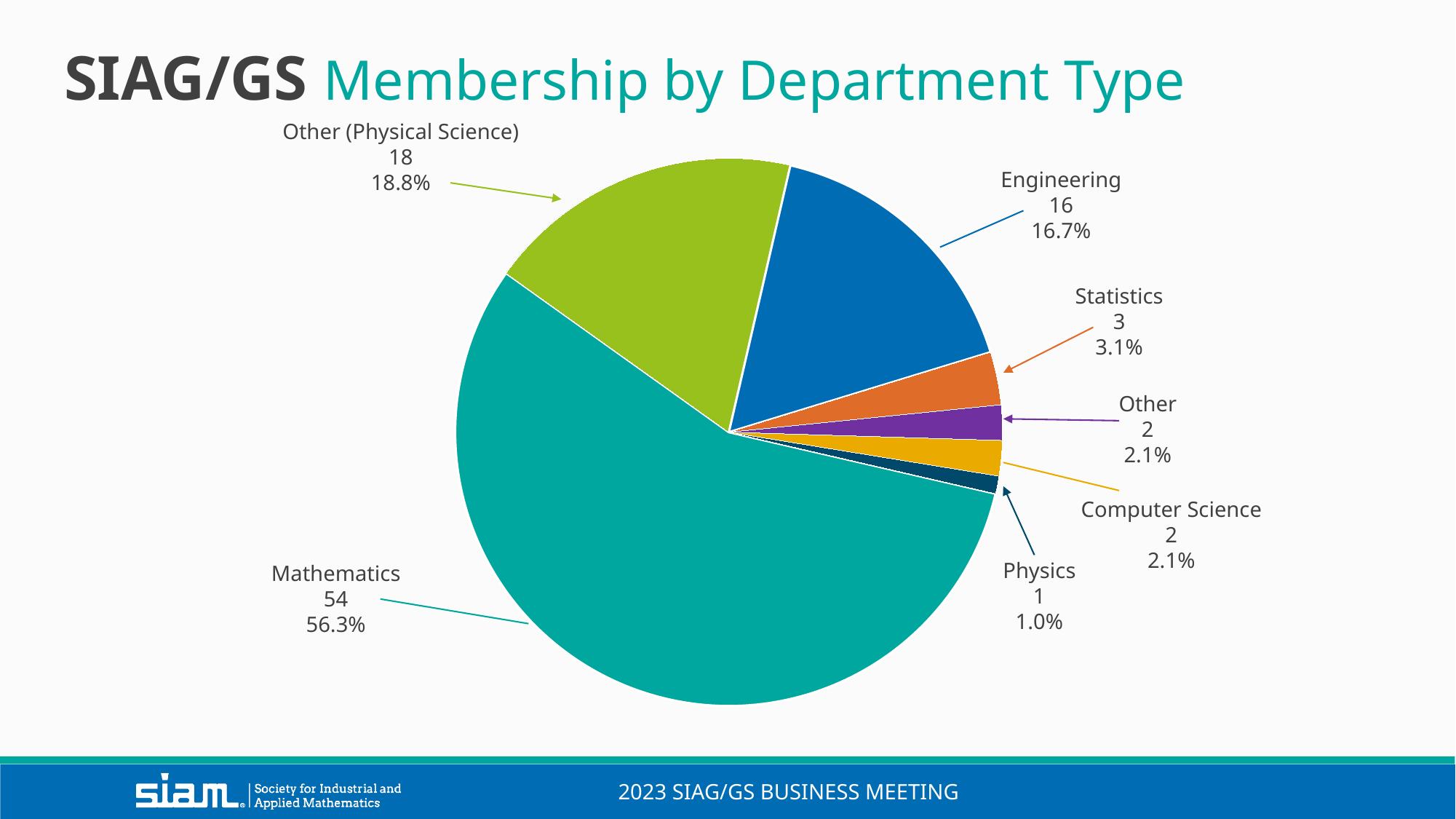
How many categories are shown in the pie chart? 7 What kind of chart is shown on the slide? pie chart What percentage share does Engineering have? 16.7% What is the difference in member count between Other (Physical Science) and Engineering? 2 How many members are in the Mathematics category? 54 Which has more members, Statistics or Computer Science? Statistics Which category has the largest slice? Mathematics Which category has the smallest slice? Physics What percentage share does Mathematics have? 56.3% How many members are in the Other (Physical Science) category? 18 What is the title of the slide? SIAG/GS Membership by Department Type What is the difference in member count between Mathematics and Other (Physical Science)? 36